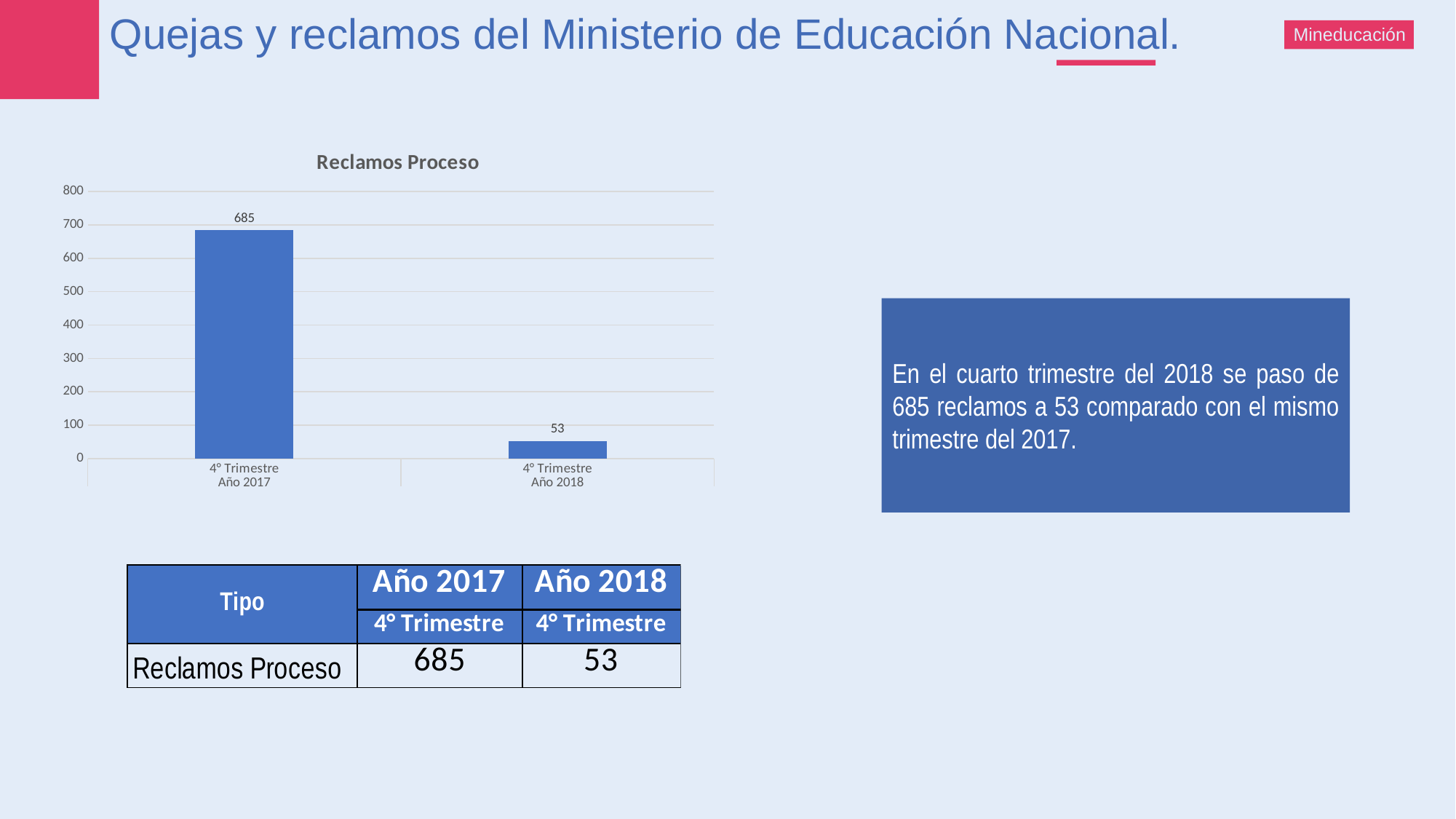
Which category has the highest value in the Reclamos Proceso chart? 4° Trimestre Año 2017 What kind of chart is the Reclamos Proceso chart? bar chart What is the value for 4° Trimestre Año 2017 in the Reclamos Proceso chart? 685 Is the value for 4° Trimestre Año 2018 greater or less than 100? less What is the title of the chart on the slide? Reclamos Proceso Which category has the lowest value in the Reclamos Proceso chart? 4° Trimestre Año 2018 How many categories are shown in the Reclamos Proceso chart? 2 Do the values rise or fall from 4° Trimestre Año 2017 to 4° Trimestre Año 2018 in the Reclamos Proceso chart? fall Which is larger in the Reclamos Proceso chart: the value for 4° Trimestre Año 2017 or 4° Trimestre Año 2018? 4° Trimestre Año 2017 What is the difference between the 4° Trimestre Año 2017 and 4° Trimestre Año 2018 values in the Reclamos Proceso chart? 632 What is the value for 4° Trimestre Año 2018 in the Reclamos Proceso chart? 53 Is the value for 4° Trimestre Año 2017 greater or less than 600? greater